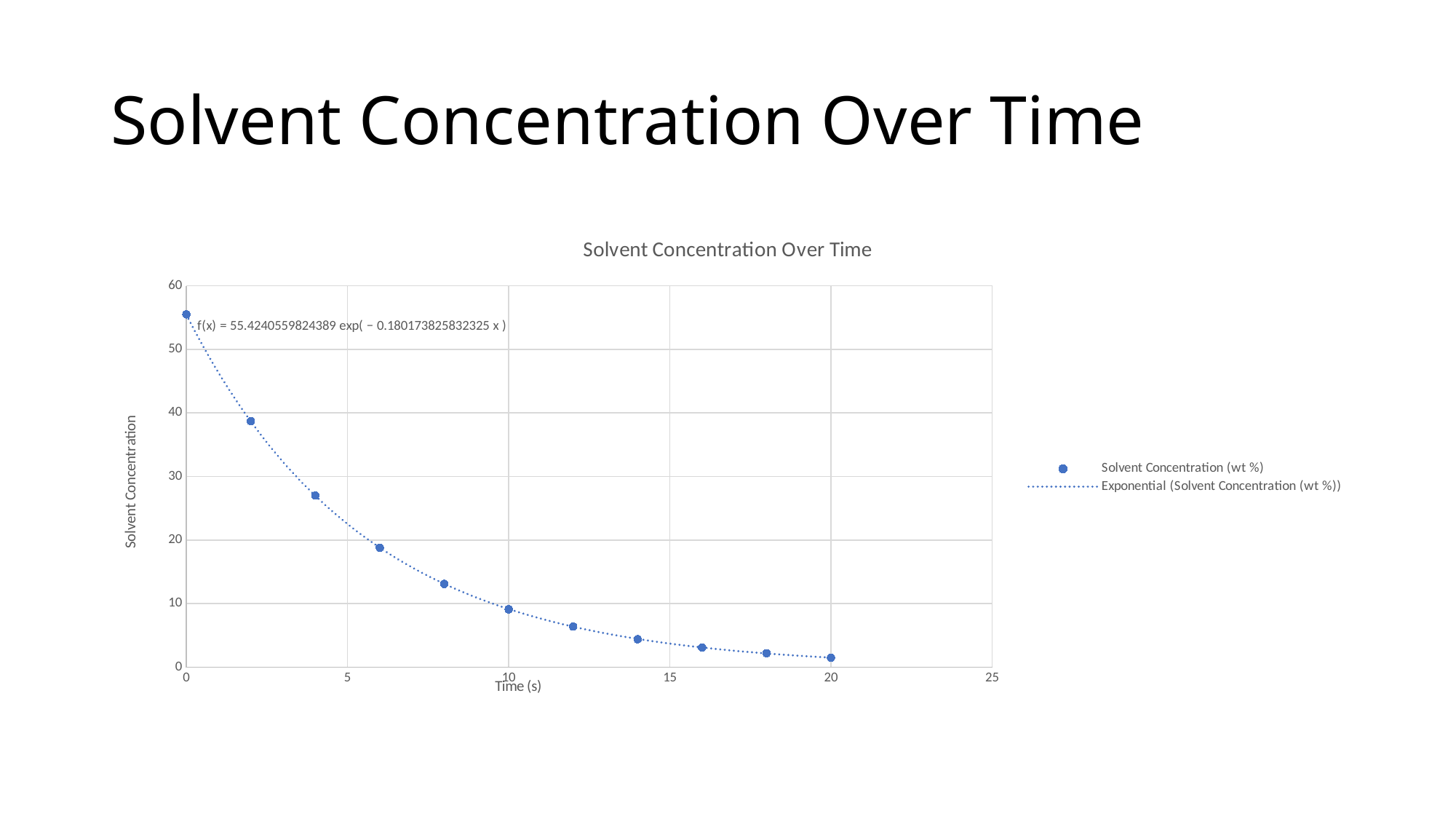
What type of trendline is fitted to the data according to the legend? Exponential Which is larger, the solvent concentration at time 2 or at time 6? Time 2 What is the label of the x axis? Time (s) At which time is the solvent concentration highest? 0 How many entries does the legend list? 2 Do the solvent concentration values rise or fall as time increases? Fall Is the solvent concentration at time 4 greater or less than 30? less How many data points are plotted for Solvent Concentration (wt %)? 11 Is the solvent concentration at time 0 greater or less than 50? greater At which time is the solvent concentration lowest? 20 What kind of chart is shown on the slide? Scatter chart